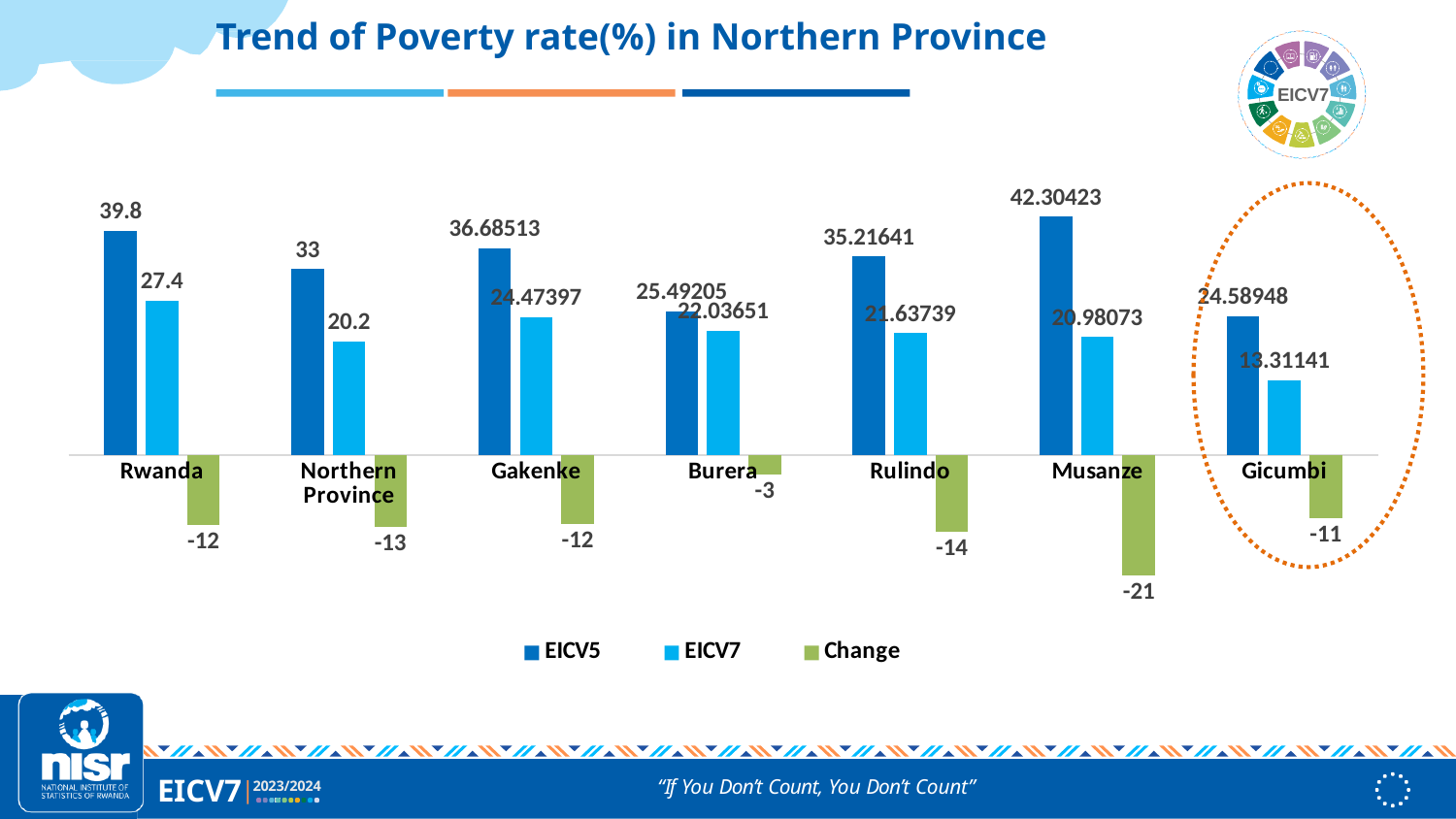
Which category has the largest negative Change value? Musanze What is the EICV5 poverty rate for Musanze? 42.30423 How many categories are shown on the x axis? 7 Which category has the highest EICV5 poverty rate? Musanze What kind of chart is shown on the slide? Bar chart What is the EICV7 poverty rate for Northern Province? 20.2 Which is larger, the EICV7 poverty rate for Rwanda or for Burera? Rwanda How many series does the legend list? 3 What is the Change value for Burera? -3 What is the EICV7 poverty rate for Gicumbi? 13.31141 Which category has the lowest EICV7 poverty rate? Gicumbi What is the difference between the EICV5 and EICV7 poverty rates for Rwanda? 12.4